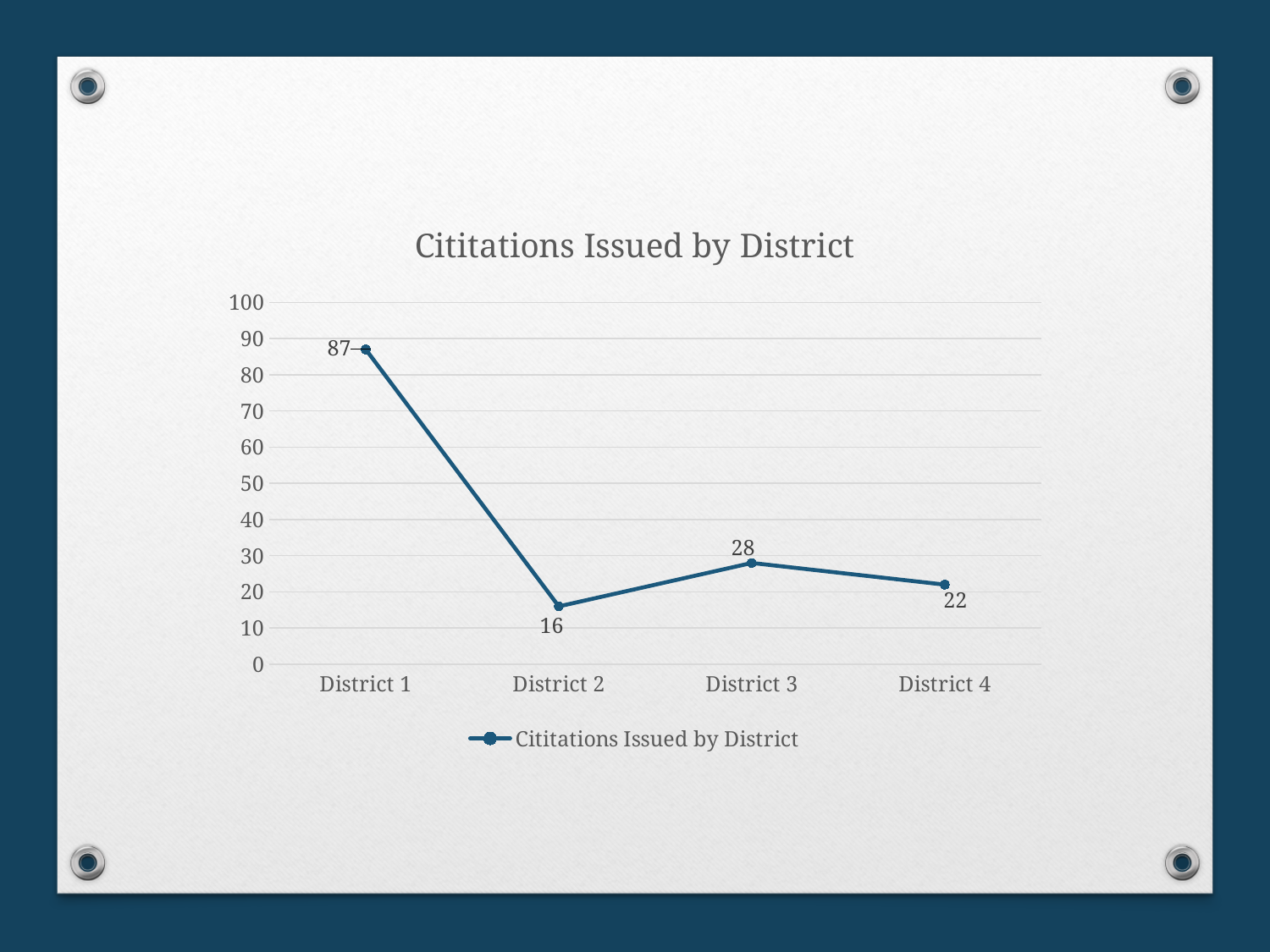
What is the value for District 2? 16 What is the title of the chart? Cititations Issued by District Which district has the highest number of citations issued? District 1 How many districts are plotted on the chart? 4 What kind of chart is shown on the slide? Line chart What is the difference between the values for District 1 and District 2? 71 What is the value for District 4? 22 Which district has the lowest number of citations issued? District 2 What is the value for District 1? 87 What is the value for District 3? 28 Which is larger, the value for District 3 or the value for District 4? District 3 What is the difference between the values for District 3 and District 4? 6